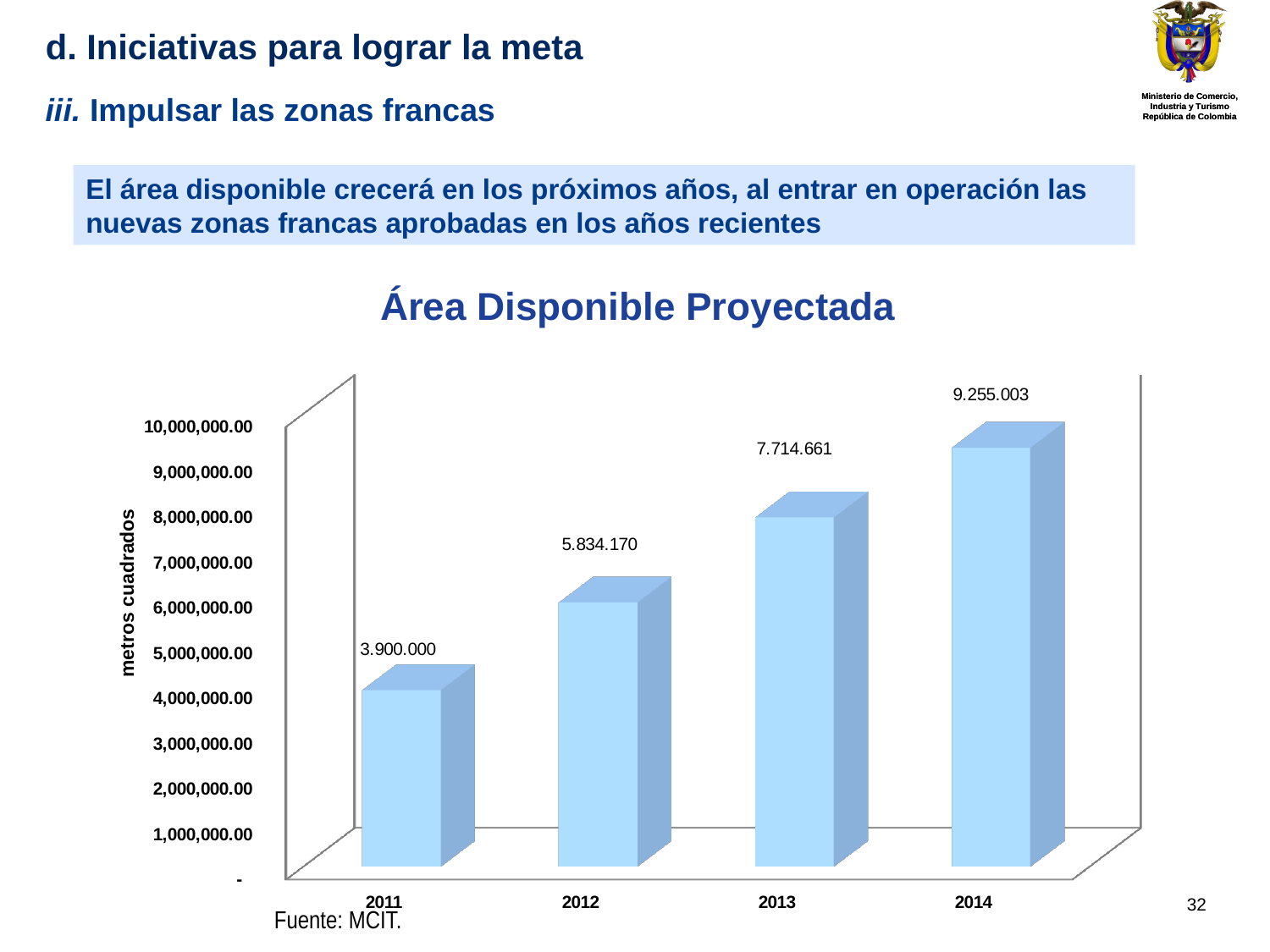
Do the values rise or fall from 2011 to 2014? Rise Which year has the highest projected available area? 2014 What is the difference between the values for 2014 and 2011? 5.355.003 Which is larger, the value for 2012 or the value for 2013? 2013 What is the value for 2014? 9.255.003 What is the value for 2012? 5.834.170 What is the value for 2013? 7.714.661 What kind of chart is shown? Bar chart What is the value for 2011? 3.900.000 Which year has the lowest projected available area? 2011 How many years are shown on the x axis? 4 What is the difference between the values for 2013 and 2012? 1.880.491